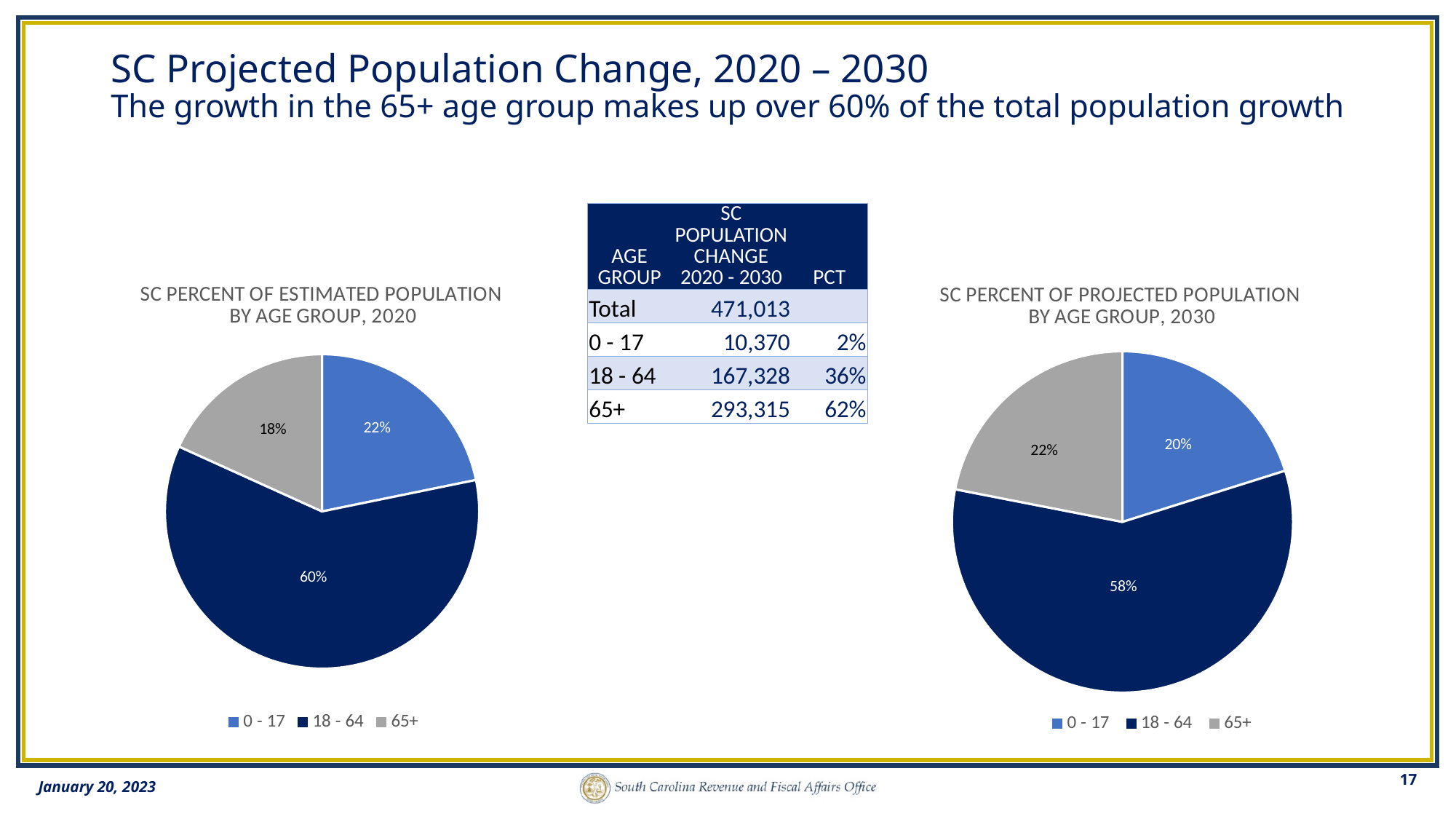
How many entries does the legend of the 2030 pie chart list? 3 Is the 18 - 64 share larger in the 2020 pie chart or the 2030 pie chart? 2020 How many slices does the 2020 pie chart have? 3 In the 2020 pie chart, which age group has the largest share? 18 - 64 In the 2020 pie chart (SC Percent of Estimated Population by Age Group, 2020), what share of the population is the 18 - 64 age group? 60% In the 2030 pie chart, what share of the population is the 65+ age group? 22% In the 2020 pie chart, what share of the population is the 65+ age group? 18% In the 2020 pie chart, what colour is the slice for the 65+ age group? Grey In the 2030 pie chart (SC Percent of Projected Population by Age Group, 2030), what share of the population is the 0 - 17 age group? 20% What type of chart is used to show SC Percent of Projected Population by Age Group, 2030? Pie chart What is the difference between the 65+ share in the 2030 pie chart and the 65+ share in the 2020 pie chart? 4 percentage points In the 2030 pie chart, which age group has the smallest share? 0 - 17